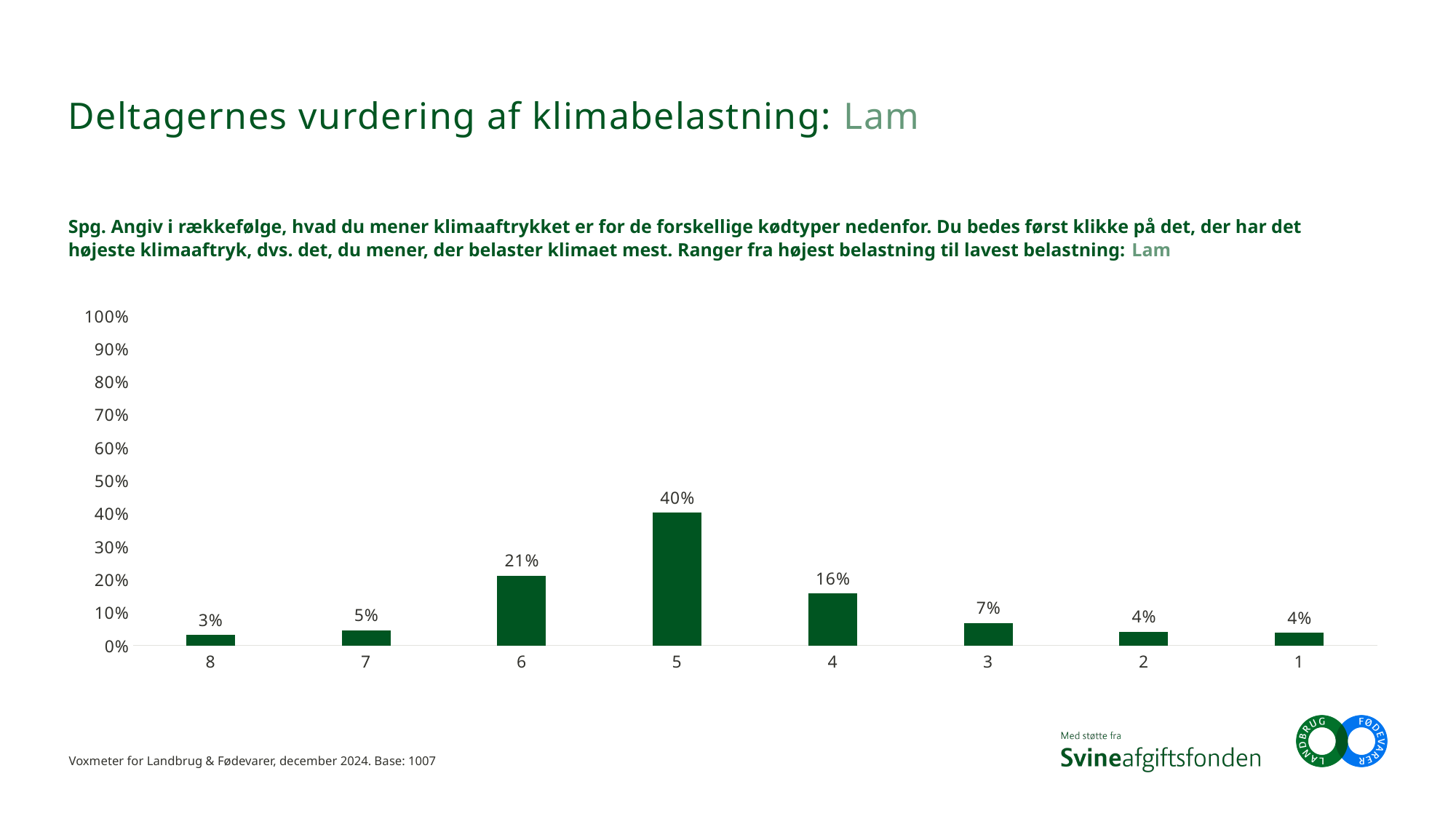
How many categories are shown on the x axis? 8 What kind of chart is shown on the slide? bar chart What is the difference between the values for category 5 and category 4? 24% What is the value for category 6? 21% What is the value for category 5? 40% What is the difference between the values for category 6 and category 7? 16% Which category has the lowest value? 8 What is the value for category 8? 3% Which category has the highest value? 5 What is the title of the slide? Deltagernes vurdering af klimabelastning: Lam Is the value for category 5 greater or less than 30%? greater Which is larger, the value for category 6 or the value for category 3? 6